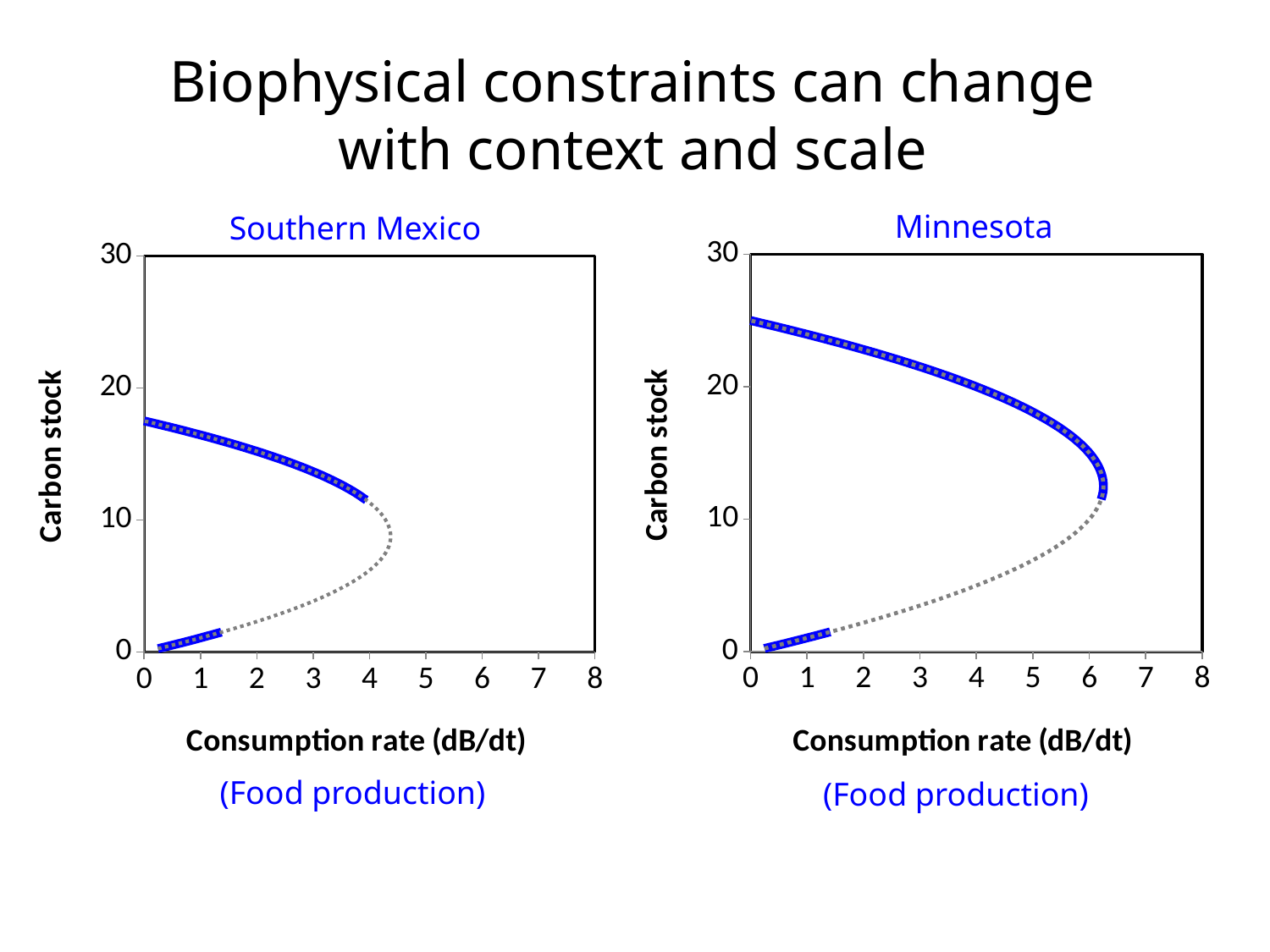
Which chart shows the higher carbon stock at a consumption rate of 0 on the upper branch, Southern Mexico or Minnesota? Minnesota What is the x-axis label of the Minnesota chart? Consumption rate (dB/dt) What is the y-axis label of the Southern Mexico chart? Carbon stock In the Southern Mexico chart, is the carbon stock of the upper branch at a consumption rate of 0 greater or less than 10? greater What kind of chart is the Southern Mexico chart? line chart In the Southern Mexico chart, does the carbon stock of the lower branch rise or fall as the consumption rate increases? rise In the Southern Mexico chart, is the maximum consumption rate reached by the curve greater or less than 5? less In the Minnesota chart, is the maximum consumption rate reached by the curve greater or less than 5? greater What is the highest value shown on the y axis of the Minnesota chart? 30 In the Minnesota chart, does the carbon stock of the upper branch rise or fall as the consumption rate increases? fall